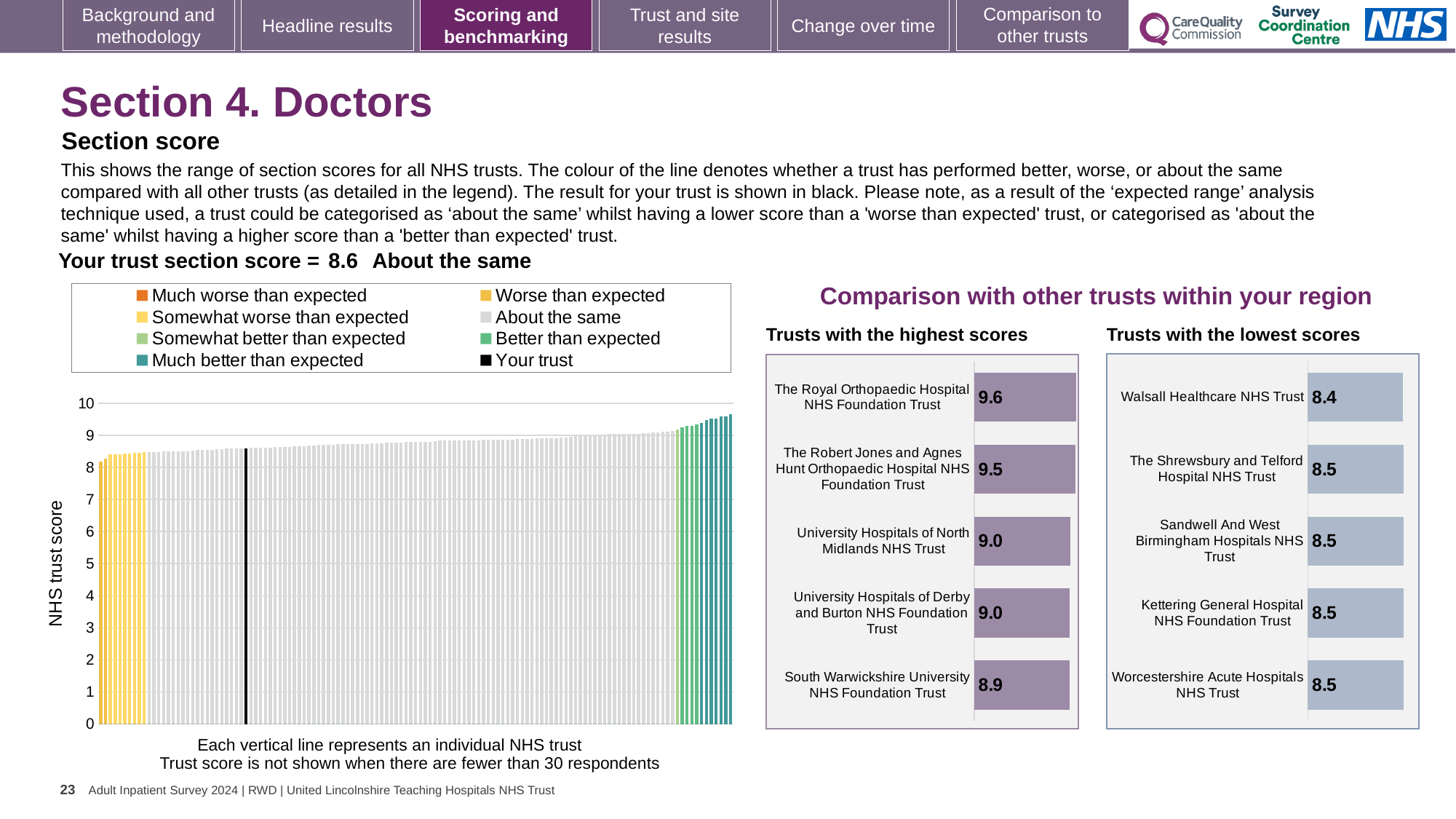
In the 'Trusts with the highest scores' chart, what is the difference between the scores of The Royal Orthopaedic Hospital NHS Foundation Trust and South Warwickshire University NHS Foundation Trust? 0.7 How many trusts are listed in the 'Trusts with the lowest scores' chart? 5 In the 'Trusts with the lowest scores' chart, what is the score for Walsall Healthcare NHS Trust? 8.4 In the 'Trusts with the highest scores' chart, what is the score for South Warwickshire University NHS Foundation Trust? 8.9 In the large 'NHS trust score' chart on the left, is the value of the black 'Your trust' bar greater or less than 9? less In the 'Trusts with the highest scores' chart, which trust has the highest score? The Royal Orthopaedic Hospital NHS Foundation Trust In the 'Trusts with the lowest scores' chart, which trust has the lowest score? Walsall Healthcare NHS Trust Which is larger: the score for The Robert Jones and Agnes Hunt Orthopaedic Hospital NHS Foundation Trust in the highest scores chart, or the score for Kettering General Hospital NHS Foundation Trust in the lowest scores chart? The Robert Jones and Agnes Hunt Orthopaedic Hospital NHS Foundation Trust In the large 'NHS trust score' chart on the left, do the trust scores rise or fall from left to right along the x axis? Rise In the large 'NHS trust score' chart on the left, how many entries does the legend list? 8 What kind of chart is the large 'NHS trust score' chart on the left of the slide? Bar chart In the 'Trusts with the highest scores' chart, what is the score for The Royal Orthopaedic Hospital NHS Foundation Trust? 9.6